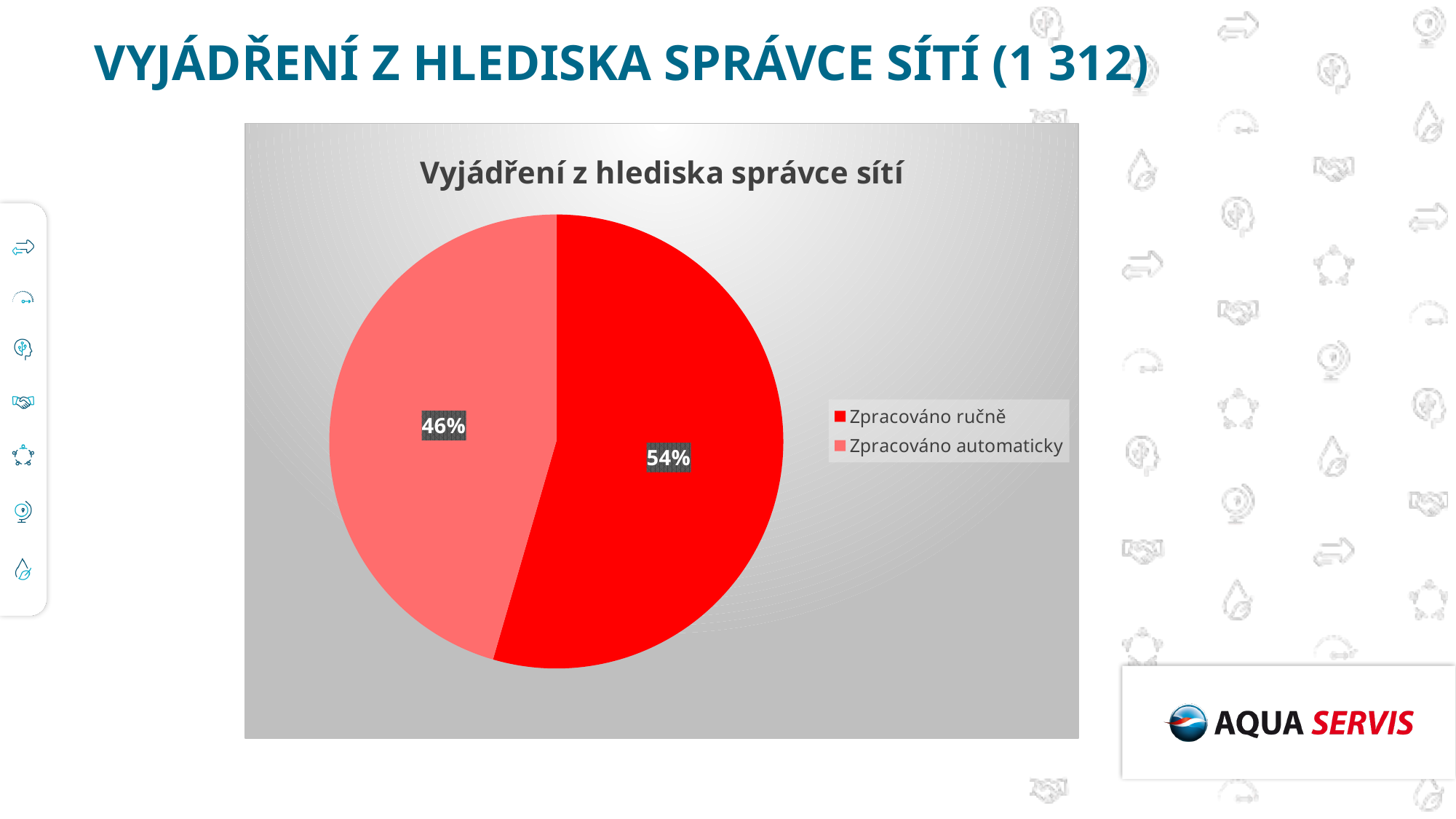
How many slices does the pie chart have? 2 What kind of chart is shown on the slide? pie chart What share of the pie is labelled "Zpracováno ručně"? 54% What colour is the "Zpracováno ručně" slice? red Which slice of the pie is the smallest? Zpracováno automaticky What share of the pie is labelled "Zpracováno automaticky"? 46% How many entries does the legend list? 2 Which is larger: the "Zpracováno ručně" slice or the "Zpracováno automaticky" slice? Zpracováno ručně What is the title of the chart? Vyjádření z hlediska správce sítí Which slice of the pie is the largest? Zpracováno ručně What is the difference in percentage points between the "Zpracováno ručně" and "Zpracováno automaticky" slices? 8 percentage points